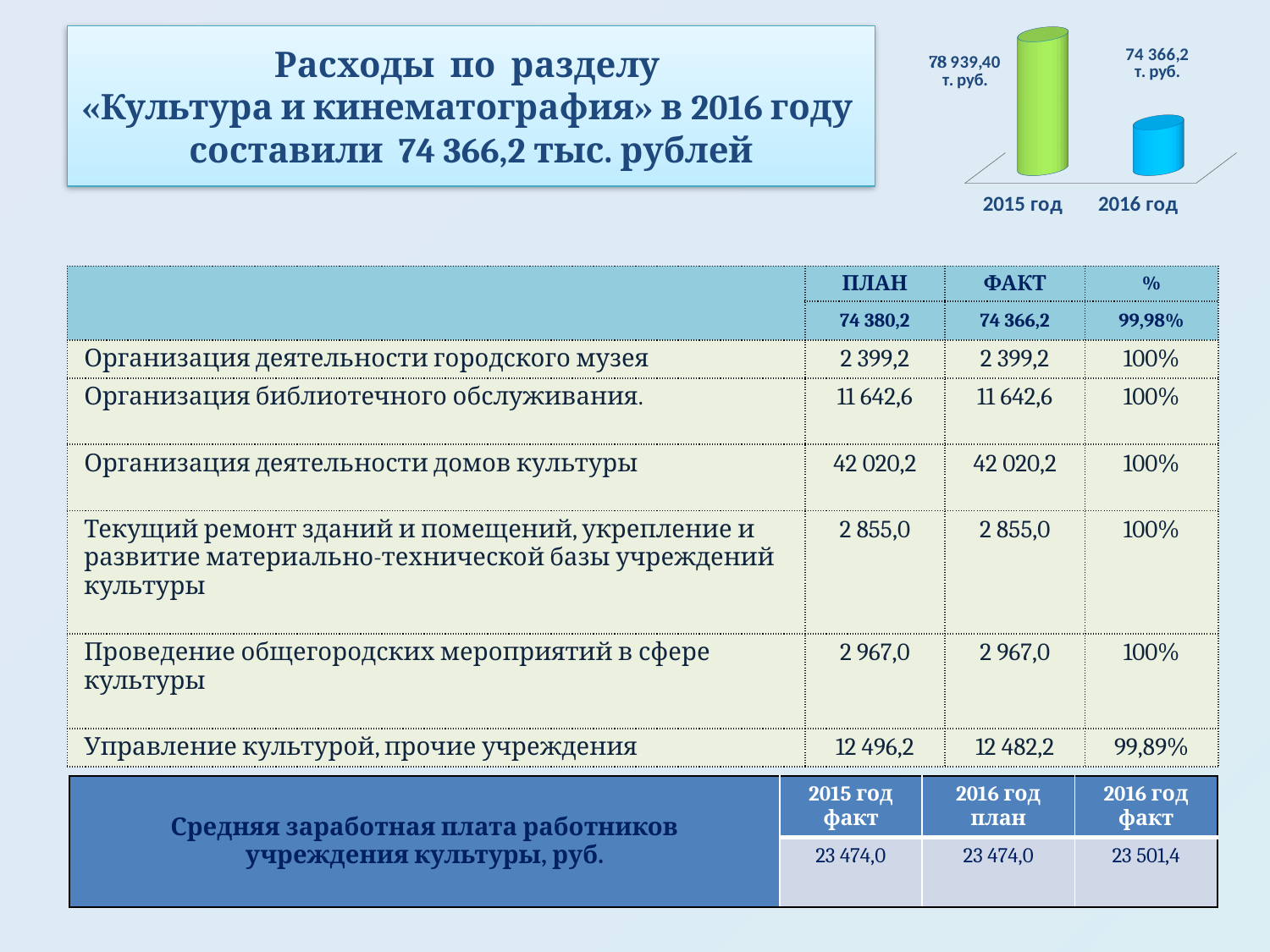
In the bar chart, what is the value for 2015 год? 78 939,40 т. руб. In the bar chart, what colour is the bar for 2016 год? blue In the bar chart, do the values rise or fall from 2015 год to 2016 год? fall In the bar chart, what is the value for 2016 год? 74 366,2 т. руб. In the bar chart, which year has the lower value? 2016 год How many bars are shown in the bar chart? 2 What kind of chart is shown in the top right of the slide? bar chart In the bar chart, what is the difference between the 2015 год and 2016 год values? 4 573,2 т. руб. In the bar chart, which year has the higher value? 2015 год In the bar chart, what colour is the bar for 2015 год? green In the bar chart, is the value for 2015 год larger or smaller than the value for 2016 год? larger